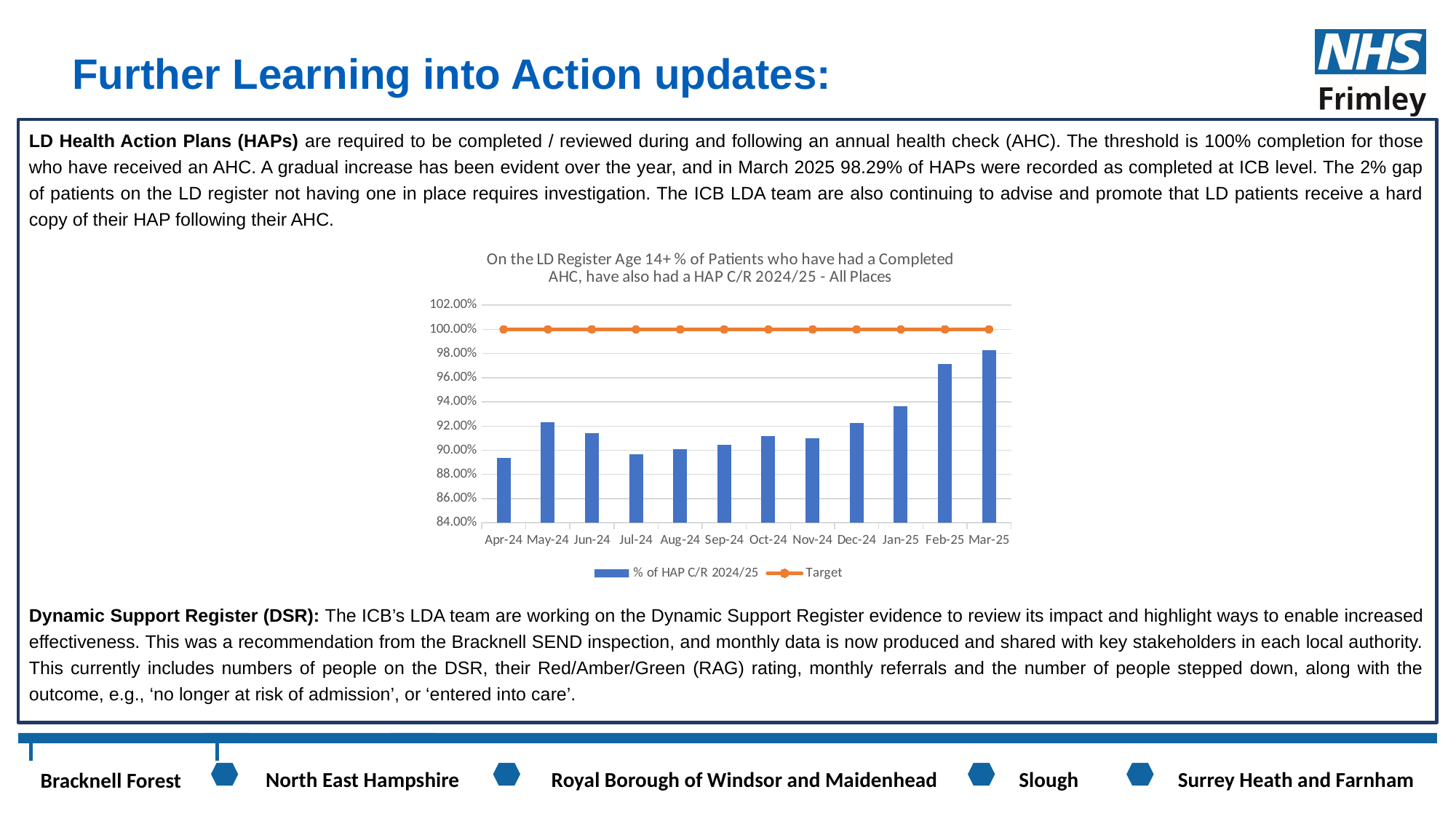
How many months are plotted along the x axis of the chart? 12 What value does the Target line sit at throughout the chart? 100.00% Is the % of HAP C/R value for Jan-25 greater or less than 92.00%? greater Which has the larger % of HAP C/R bar, May-24 or Jul-24? May-24 Which month has the highest % of HAP C/R 2024/25 bar? Mar-25 What are the two entries in the chart legend? % of HAP C/R 2024/25 and Target Is the % of HAP C/R value for Feb-25 greater or less than 96.00%? greater How many series does the chart legend list? 2 Is the % of HAP C/R value for Apr-24 greater or less than 90.00%? less Which has the larger % of HAP C/R bar, Feb-25 or Jan-25? Feb-25 What kind of chart is shown on the slide? bar and line chart Do the % of HAP C/R bars rise or fall from Jul-24 to Mar-25? rise